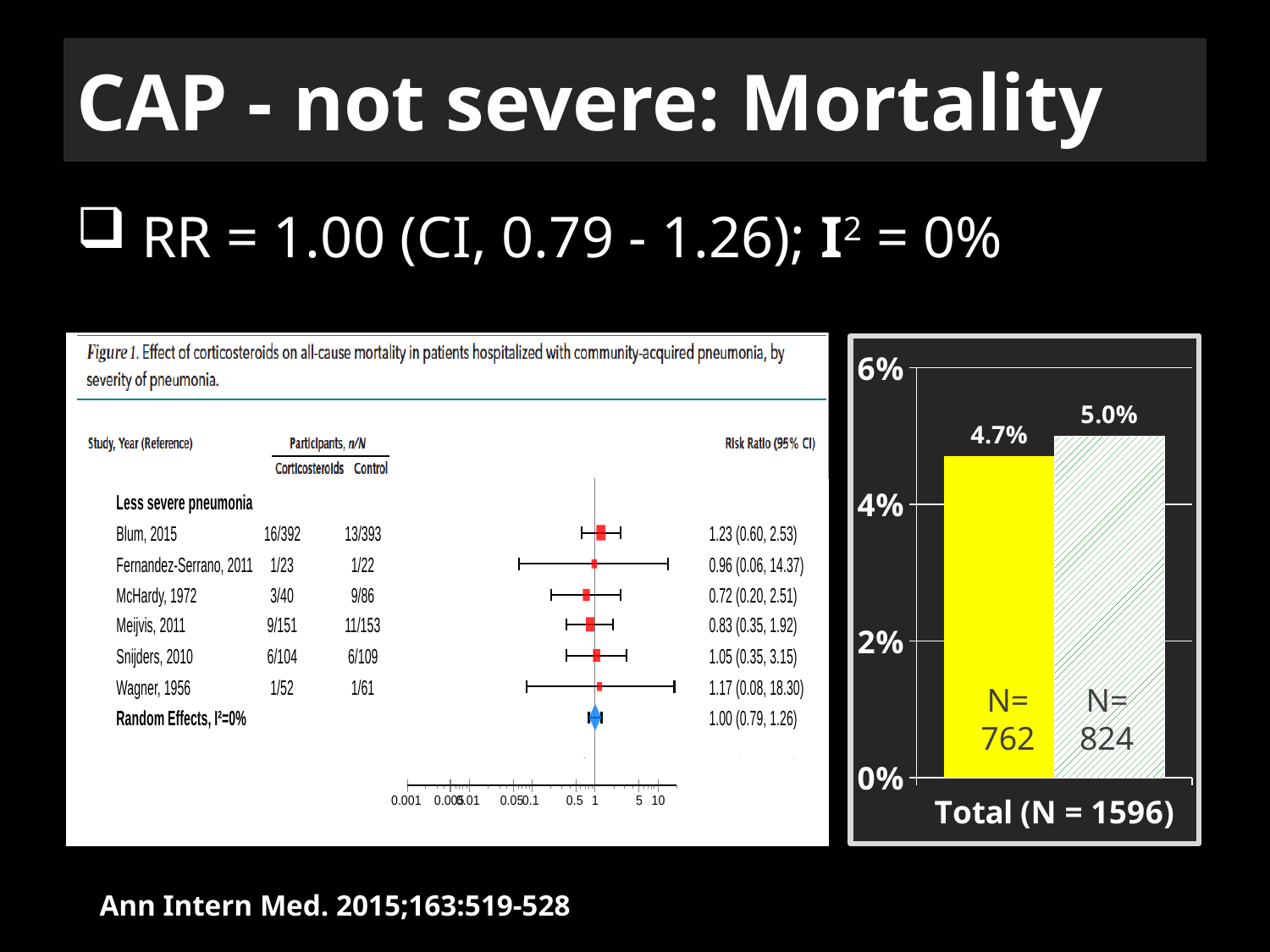
In the forest plot on the left, what is the random effects pooled risk ratio (95% CI)? 1.00 (0.79, 1.26) What kind of chart is shown on the right side of the slide? bar chart In the bar chart on the right, what is the difference between the hatched bar (5.0%) and the yellow bar (4.7%)? 0.3% In the forest plot on the left, how many individual studies are listed under less severe pneumonia? 6 What is the title printed below the bar chart on the right? Total (N = 1596) In the bar chart on the right, what is the value of the yellow bar (N=762)? 4.7% In the bar chart on the right, which bar is higher, the yellow bar (N=762) or the hatched bar (N=824)? the hatched bar (N=824) In the forest plot on the left, what is the risk ratio (95% CI) for Blum, 2015? 1.23 (0.60, 2.53) In the bar chart on the right, how many bars are plotted? 2 In the bar chart on the right, is the value of the yellow bar greater or less than 4%? greater In the bar chart on the right, what is the value of the hatched bar (N=824)? 5.0% In the forest plot on the left, which study has the lowest point estimate of risk ratio? McHardy, 1972